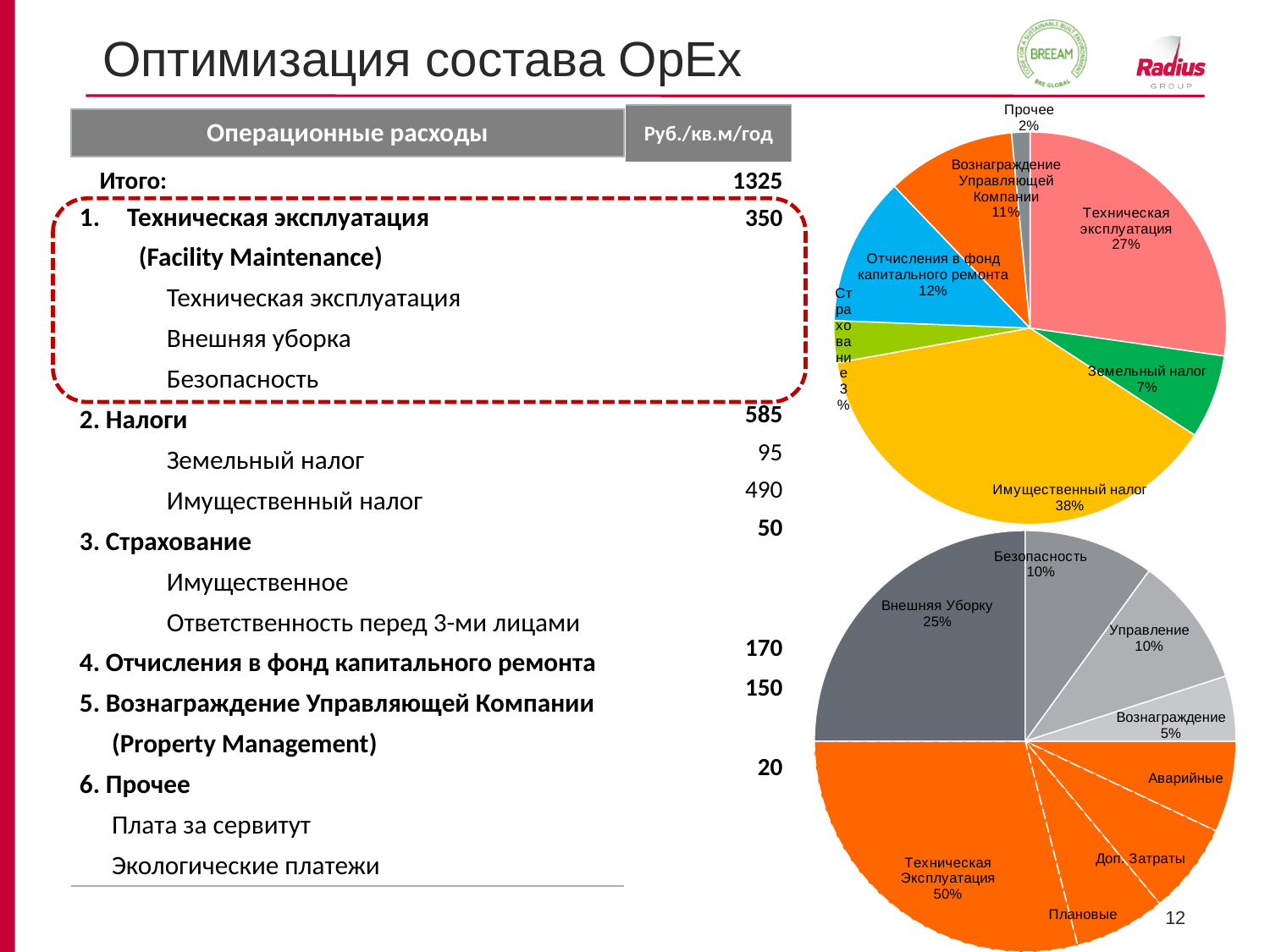
In the top pie chart, which category has the smallest share? Прочее In the bottom pie chart, what share does Внешняя Уборка have? 25% In the bottom pie chart, what share does Техническая Эксплуатация have? 50% In the bottom pie chart, what is the difference in percentage points between Внешняя Уборка and Вознаграждение? 20 In the bottom pie chart, which category has the largest share? Техническая Эксплуатация In the top pie chart, what share does Техническая эксплуатация have? 27% What type of chart is the top chart on the slide? Pie chart In the top pie chart, which is larger: Земельный налог or Вознаграждение Управляющей Компании? Вознаграждение Управляющей Компании In the top pie chart, which category has the largest share? Имущественный налог In the top pie chart, what share does Отчисления в фонд капитального ремонта have? 12% In the top pie chart, what is the difference in percentage points between Имущественный налог and Техническая эксплуатация? 11 In the top pie chart, what share does Имущественный налог have? 38%